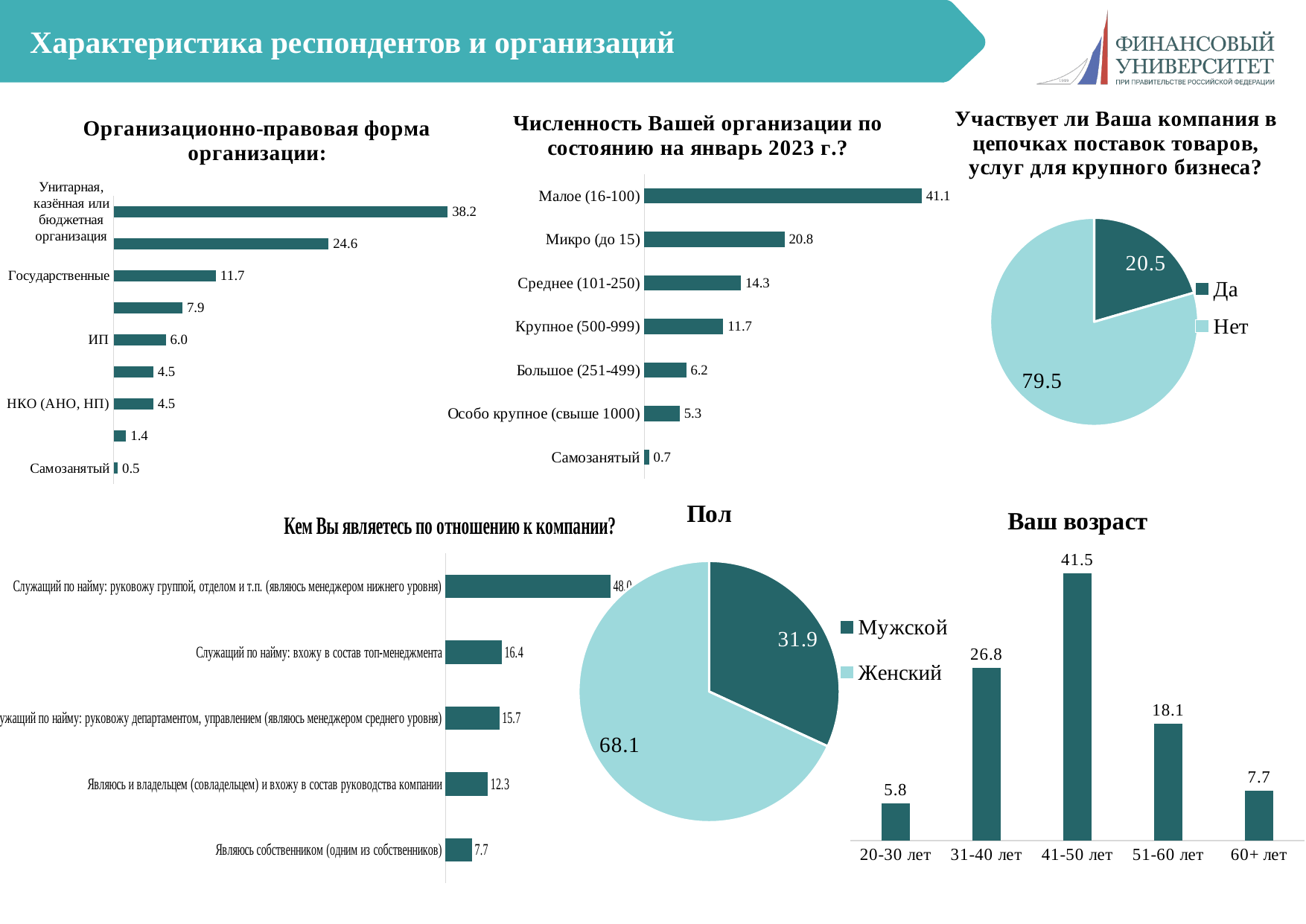
In the chart 'Ваш возраст', what is the value for '20-30 лет'? 5.8 In the chart 'Организационно-правовая форма организации:', what is the value for 'ИП'? 6.0 In the chart 'Численность Вашей организации по состоянию на январь 2023 г.?', what is the value for 'Малое (16-100)'? 41.1 In the pie chart 'Участвует ли Ваша компания в цепочках поставок товаров, услуг для крупного бизнеса?', what is the value for 'Да'? 20.5 In the pie chart 'Пол', which is larger, 'Мужской' or 'Женский'? Женский In the chart 'Ваш возраст', which age group has the highest value? 41-50 лет What kind of chart is 'Ваш возраст'? Bar chart In the chart 'Численность Вашей организации по состоянию на январь 2023 г.?', which category has the lowest value? Самозанятый In the pie chart 'Пол', what is the value for 'Мужской'? 31.9 In the chart 'Кем Вы являетесь по отношению к компании?', what is the value for 'Служащий по найму: вхожу в состав топ-менеджмента'? 16.4 In the chart 'Численность Вашей организации по состоянию на январь 2023 г.?', how many categories are shown? 7 In the chart 'Численность Вашей организации по состоянию на январь 2023 г.?', what is the difference between 'Микро (до 15)' and 'Среднее (101-250)'? 6.5